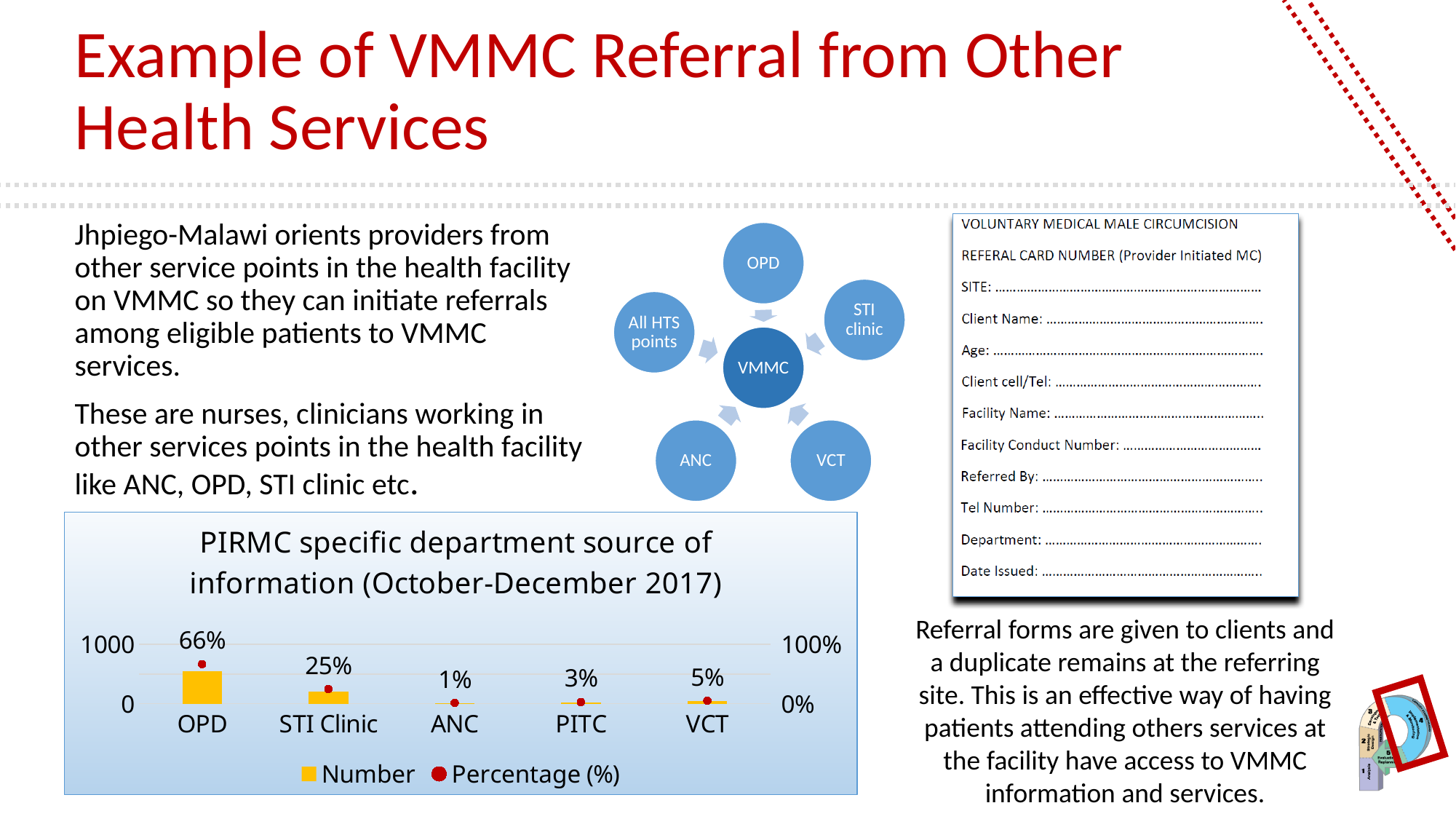
In the chart 'PIRMC specific department source of information (October-December 2017)', what is the percentage for VCT? 5% In the chart 'PIRMC specific department source of information (October-December 2017)', is the Number value for OPD greater or less than 1000? less In the chart 'PIRMC specific department source of information (October-December 2017)', what is the difference in percentage between OPD and STI Clinic? 41% In the chart 'PIRMC specific department source of information (October-December 2017)', which department has the highest percentage? OPD In the chart 'PIRMC specific department source of information (October-December 2017)', what is the percentage for OPD? 66% In the chart 'PIRMC specific department source of information (October-December 2017)', which department has the lowest percentage? ANC In the chart 'PIRMC specific department source of information (October-December 2017)', what is the percentage for PITC? 3% How many departments are shown on the x axis of the chart 'PIRMC specific department source of information (October-December 2017)'? 5 In the chart 'PIRMC specific department source of information (October-December 2017)', which has a larger percentage, PITC or VCT? VCT In the chart 'PIRMC specific department source of information (October-December 2017)', what is the percentage for STI Clinic? 25% In the chart 'PIRMC specific department source of information (October-December 2017)', what is the percentage for ANC? 1% How many series does the legend of the chart 'PIRMC specific department source of information (October-December 2017)' list? 2